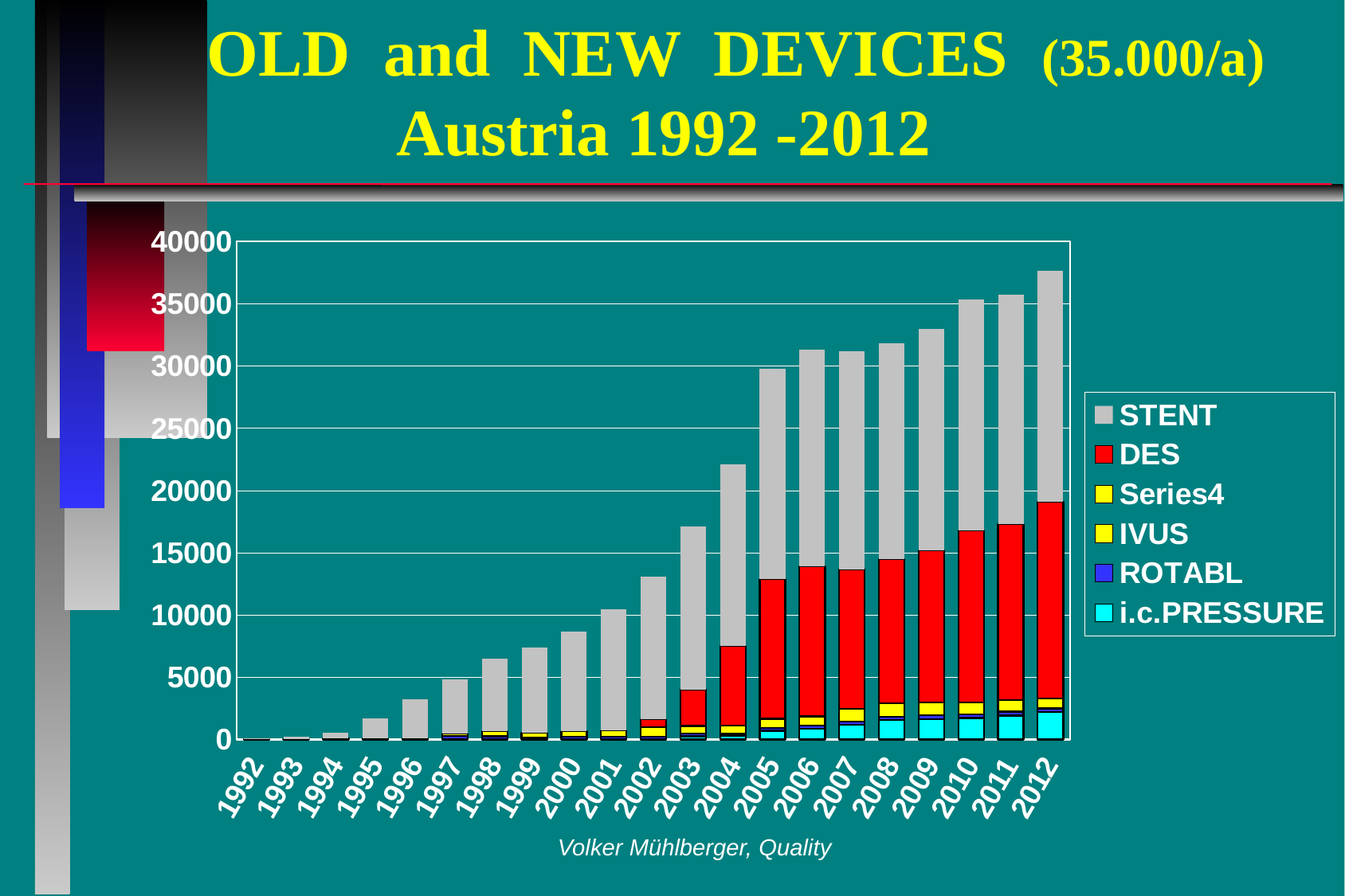
Is the total bar height for 2000 greater or less than 10000? less How many series does the chart legend list? 6 Do the total bar heights generally rise or fall from 1992 to 2012? rise Which year has the taller total bar, 2003 or 2004? 2004 Which year has the tallest bar in the chart? 2012 How many years are shown along the x axis of the chart? 21 Which year has the smallest bar in the chart? 1992 Is the total bar height for 2004 greater or less than 20000? greater Is the total bar height for 2012 greater or less than 35000? greater Which series is shown in red in the chart legend? DES What kind of chart is shown on the slide? stacked bar chart